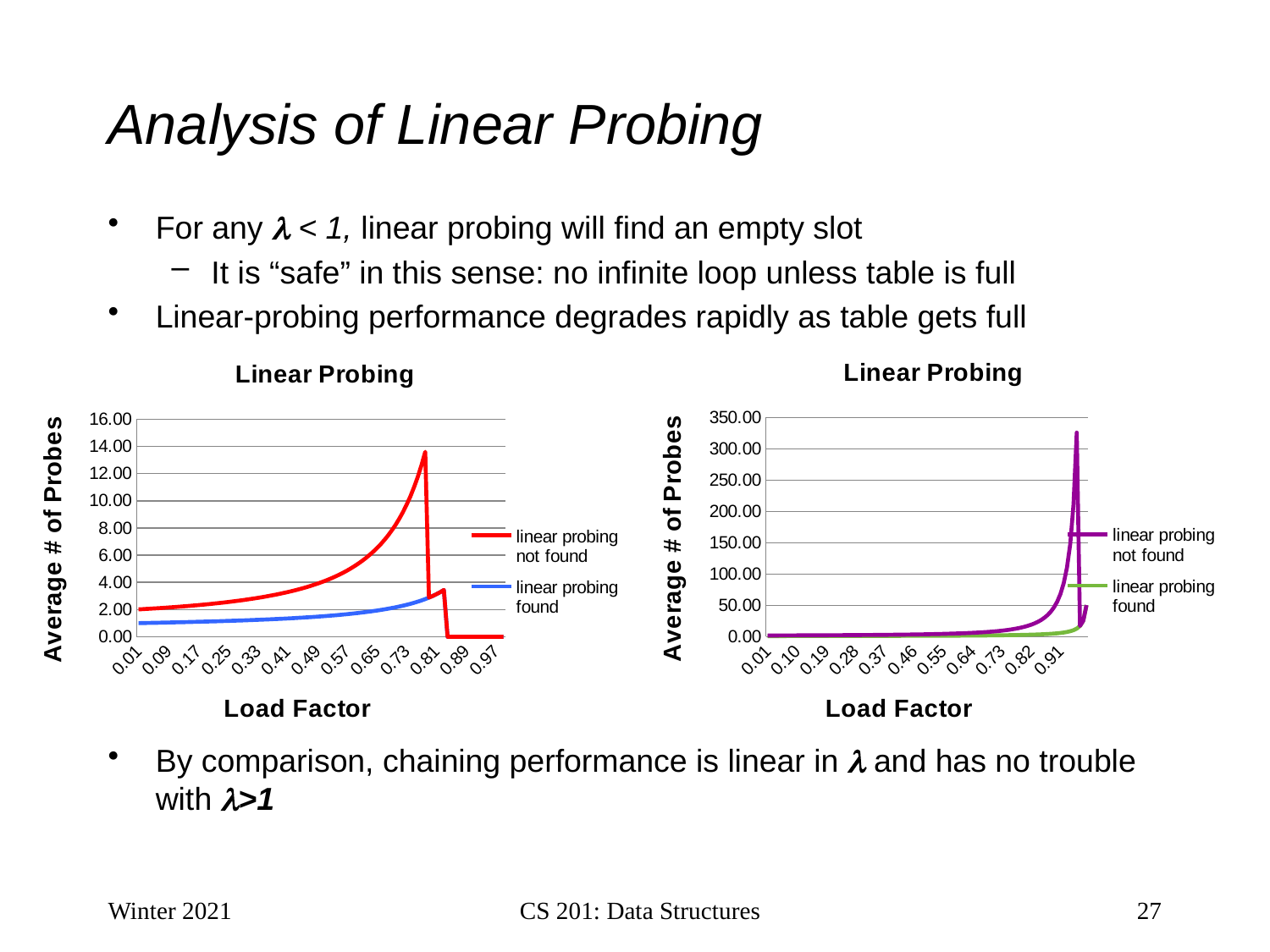
What type of chart is the left chart on the slide? line chart How many series does the legend of the right chart list? 2 In the right chart, is the peak value of the 'linear probing not found' series greater or less than 300.00? greater In the right chart, which series reaches the higher maximum value? linear probing not found In the right chart, is the value of 'linear probing found' at load factor 0.82 greater or less than 50.00? less What is the y-axis title of the left chart? Average # of Probes In the left chart, is the value of 'linear probing found' at load factor 0.73 greater or less than 4.00? less How many series does the legend of the left chart list? 2 In the left chart, does the 'linear probing not found' series rise or fall as the load factor increases from 0.01 to 0.73? rise What colour is the 'linear probing found' line in the right chart? green In the left chart, which series has the higher value at load factor 0.49, 'linear probing not found' or 'linear probing found'? linear probing not found